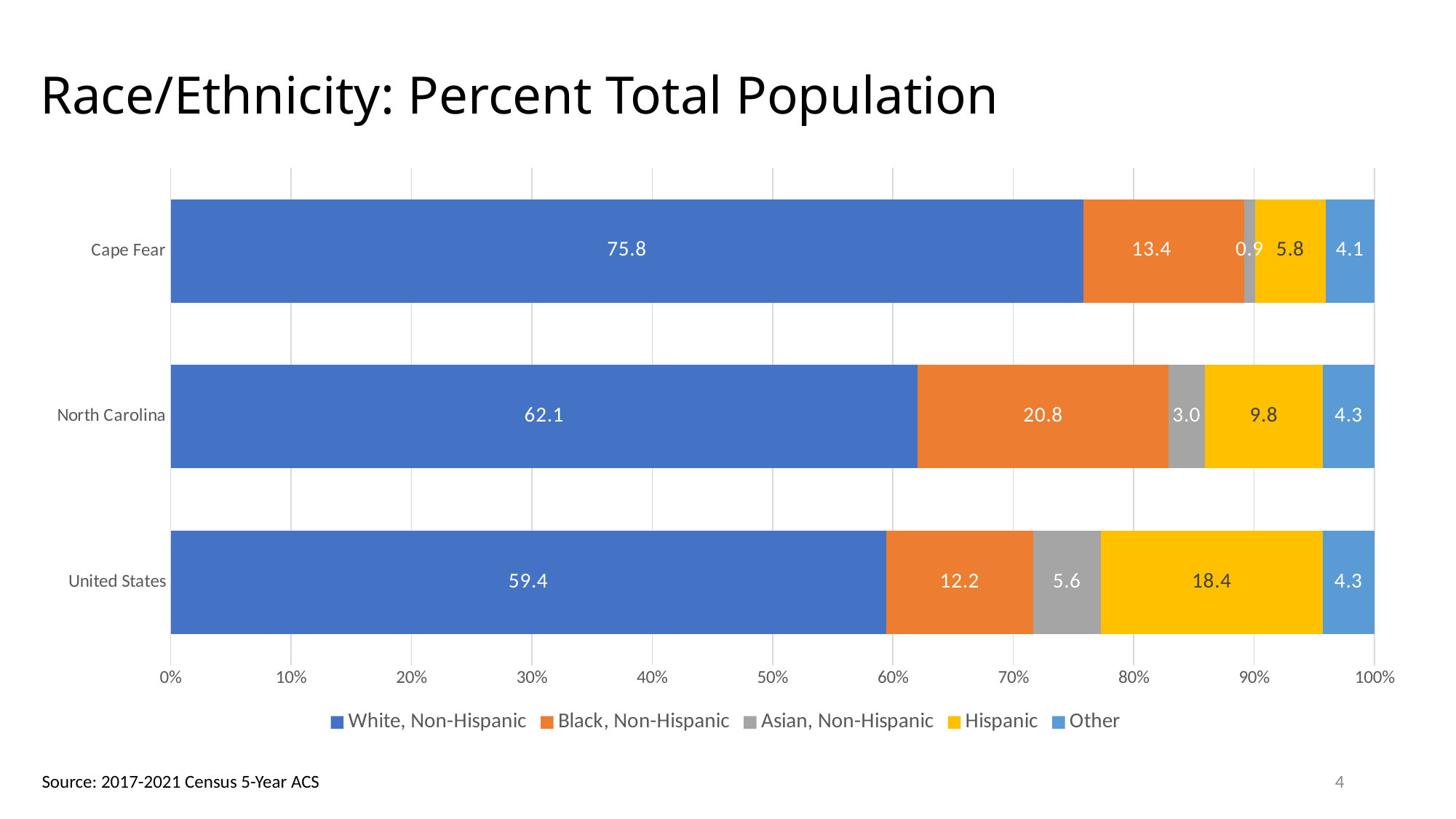
Which is larger, the Hispanic percentage for North Carolina or for Cape Fear? North Carolina What is the total of the stacked bar for the United States? 99.9 How many regions are shown on the chart? 3 What is the Hispanic percentage for the United States? 18.4 What is the Asian, Non-Hispanic percentage for North Carolina? 3.0 What is the difference between the Black, Non-Hispanic percentages for North Carolina and Cape Fear? 7.4 Which region has the lowest Asian, Non-Hispanic percentage? Cape Fear What is the White, Non-Hispanic percentage for Cape Fear? 75.8 What kind of chart is shown on the slide? Stacked bar chart How many series does the legend list? 5 Which region has the highest White, Non-Hispanic percentage? Cape Fear What colour represents the Hispanic series in the chart? Yellow